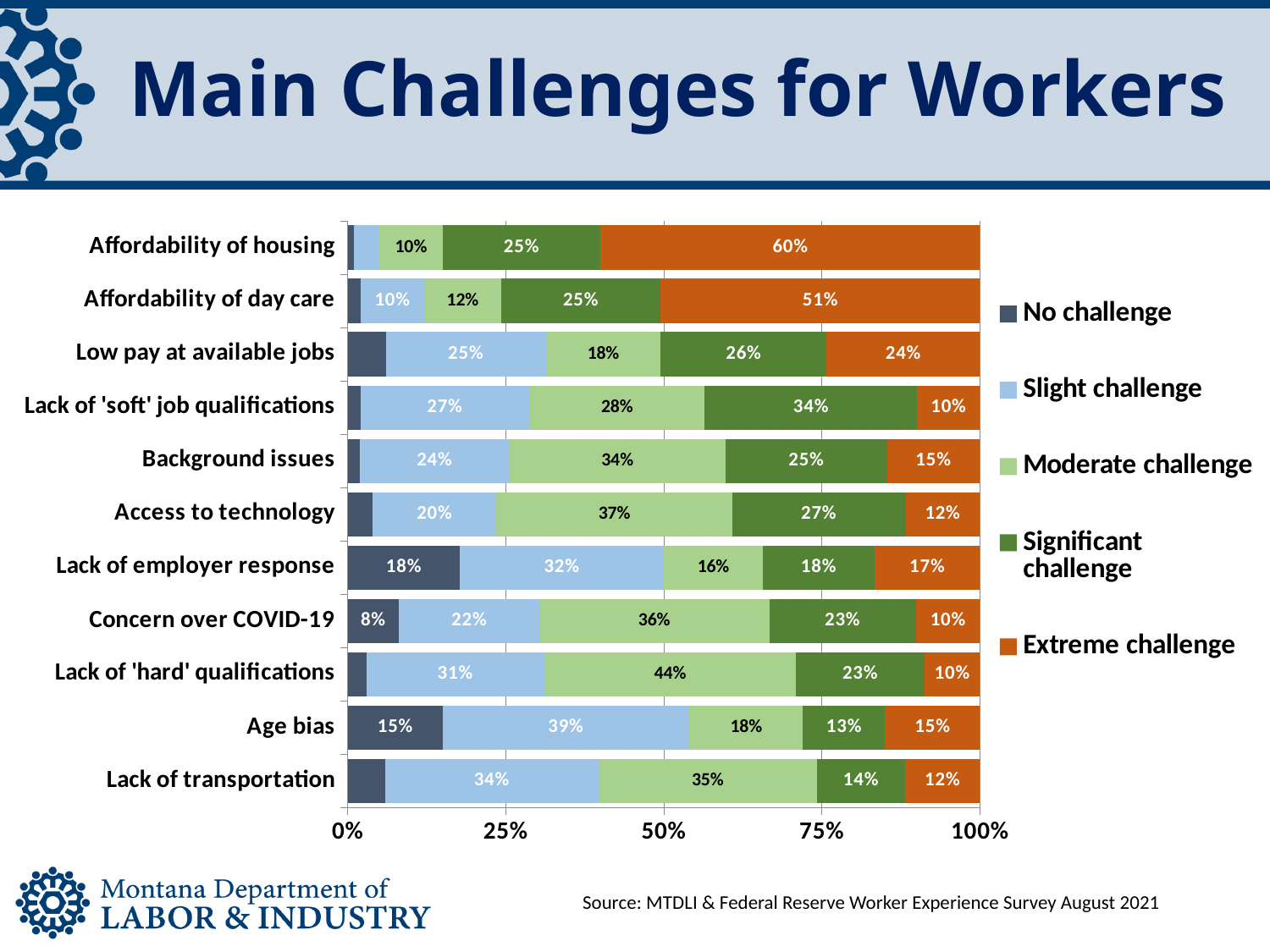
Which challenge has the highest 'Slight challenge' percentage? Age bias Which challenge has the highest 'Extreme challenge' percentage? Affordability of housing What type of chart is shown on the slide? Stacked bar chart Which is larger: the 'Moderate challenge' value for access to technology or for concern over COVID-19? Access to technology What is the 'Moderate challenge' value for lack of 'hard' qualifications? 44% What percentage of workers said lack of employer response was no challenge? 18% How many series does the legend list? 5 How many challenge categories are shown on the chart? 11 What is the difference between the 'Extreme challenge' values for affordability of housing and affordability of day care? 9% What is the 'Significant challenge' value for lack of 'soft' job qualifications? 34% What percentage of workers rated affordability of housing as an extreme challenge? 60% Which colour represents 'Extreme challenge' in the legend? Orange